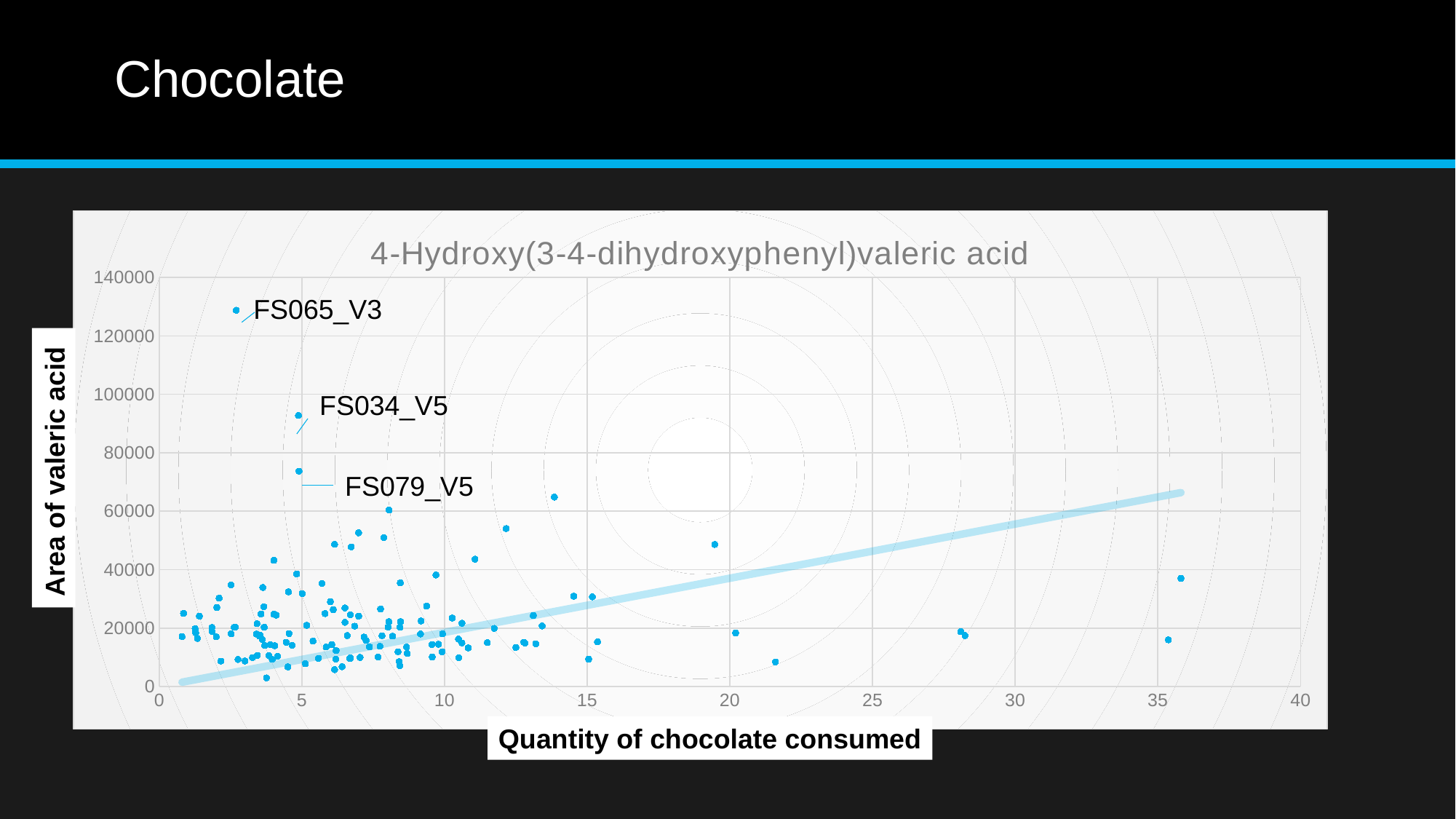
Is the quantity of chocolate consumed for FS065_V3 greater or less than 5? less Is the area of valeric acid for FS065_V3 greater or less than 120000? greater What is the label of the x axis? Quantity of chocolate consumed Which of the three labelled points has the lowest area of valeric acid? FS079_V5 How many data points on the chart are labelled with a sample name? 3 Which labelled point has the highest area of valeric acid? FS065_V3 Is the area of valeric acid for FS079_V5 greater or less than 60000? greater Does the trend line rise or fall as the quantity of chocolate consumed increases? rises Which has a larger area of valeric acid, FS034_V5 or FS079_V5? FS034_V5 What is the title of the chart? 4-Hydroxy(3-4-dihydroxyphenyl)valeric acid What kind of chart is shown on the slide? scatter chart